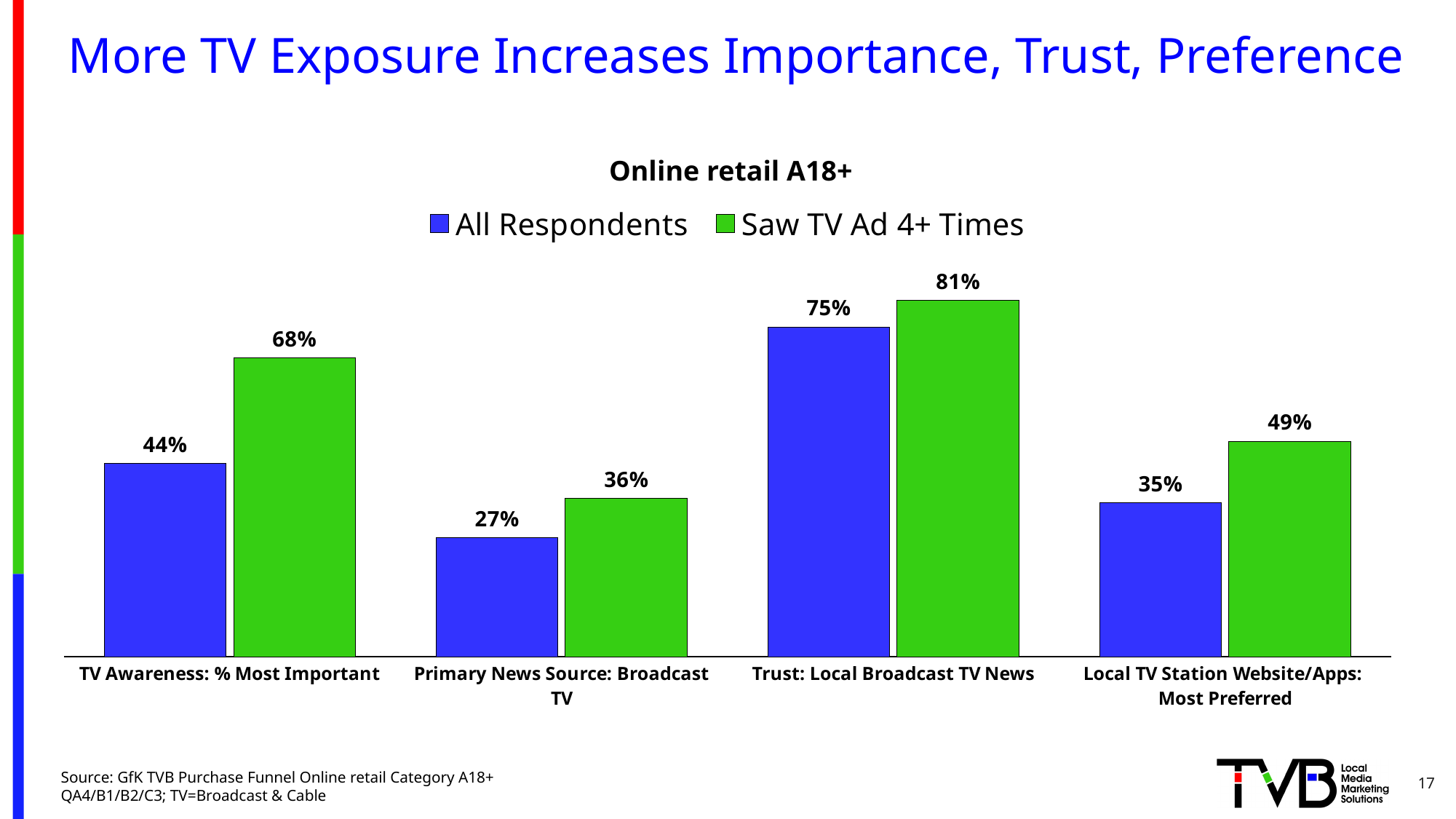
Which is larger in the Trust: Local Broadcast TV News category, All Respondents or Saw TV Ad 4+ Times? Saw TV Ad 4+ Times What is the value for Saw TV Ad 4+ Times in the Primary News Source: Broadcast TV category? 36% How many series does the legend list? 2 What is the value for Saw TV Ad 4+ Times in the Trust: Local Broadcast TV News category? 81% What is the value for All Respondents in the Local TV Station Website/Apps: Most Preferred category? 35% Which category has the lowest value for the All Respondents series? Primary News Source: Broadcast TV What is the value for All Respondents in the TV Awareness: % Most Important category? 44% What is the difference between Saw TV Ad 4+ Times and All Respondents in the TV Awareness: % Most Important category? 24% Which category has the highest value for the Saw TV Ad 4+ Times series? Trust: Local Broadcast TV News What is the difference between Saw TV Ad 4+ Times and All Respondents in the Local TV Station Website/Apps: Most Preferred category? 14% What kind of chart is shown on the slide? bar chart How many categories are shown on the x axis? 4